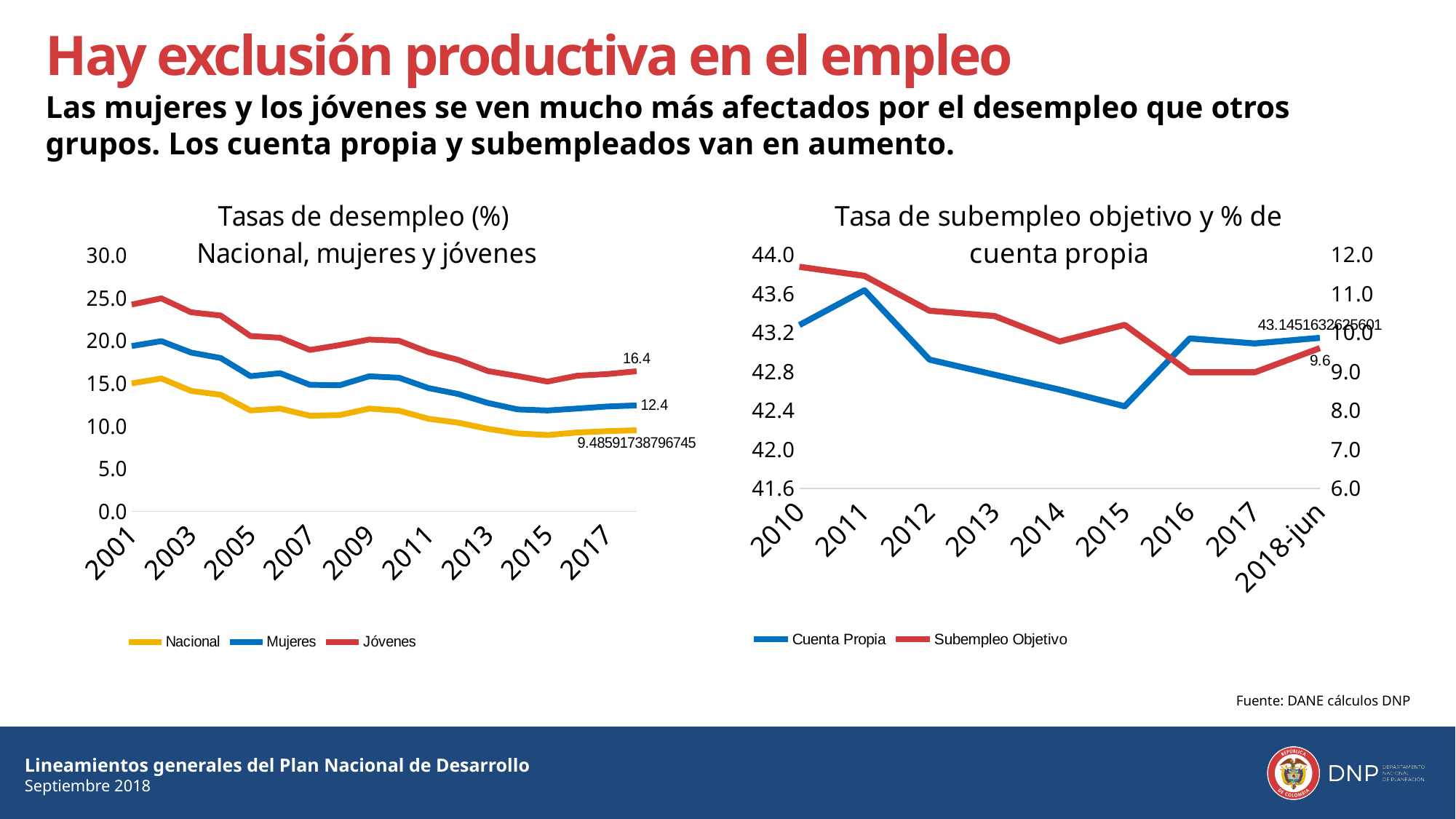
In the right chart 'Tasa de subempleo objetivo y % de cuenta propia', what is the labelled final value of the Cuenta Propia series? 43.1451632625601 In the right chart 'Tasa de subempleo objetivo y % de cuenta propia', is the Cuenta Propia value for 2015 greater or less than 42.8 on the left axis? less In the right chart 'Tasa de subempleo objetivo y % de cuenta propia', what is the labelled final value of the Subempleo Objetivo series? 9.6 In the left chart 'Tasas de desempleo (%)', what is the labelled final value of the Jóvenes series? 16.4 How many series does the legend of the right chart 'Tasa de subempleo objetivo y % de cuenta propia' list? 2 In the left chart 'Tasas de desempleo (%)', does the Jóvenes series overall rise or fall from 2001 to 2017? fall In the left chart 'Tasas de desempleo (%)', what is the labelled final value of the Nacional series? 9.48591738796745 In the left chart 'Tasas de desempleo (%)', what is the difference between the labelled final values of Jóvenes and Mujeres? 4.0 In the left chart 'Tasas de desempleo (%)', what is the labelled final value of the Mujeres series? 12.4 How many series does the legend of the left chart 'Tasas de desempleo (%)' list? 3 What kind of chart is the left chart, 'Tasas de desempleo (%) Nacional, mujeres y jóvenes'? line chart How many x-axis categories are shown on the right chart 'Tasa de subempleo objetivo y % de cuenta propia'? 9